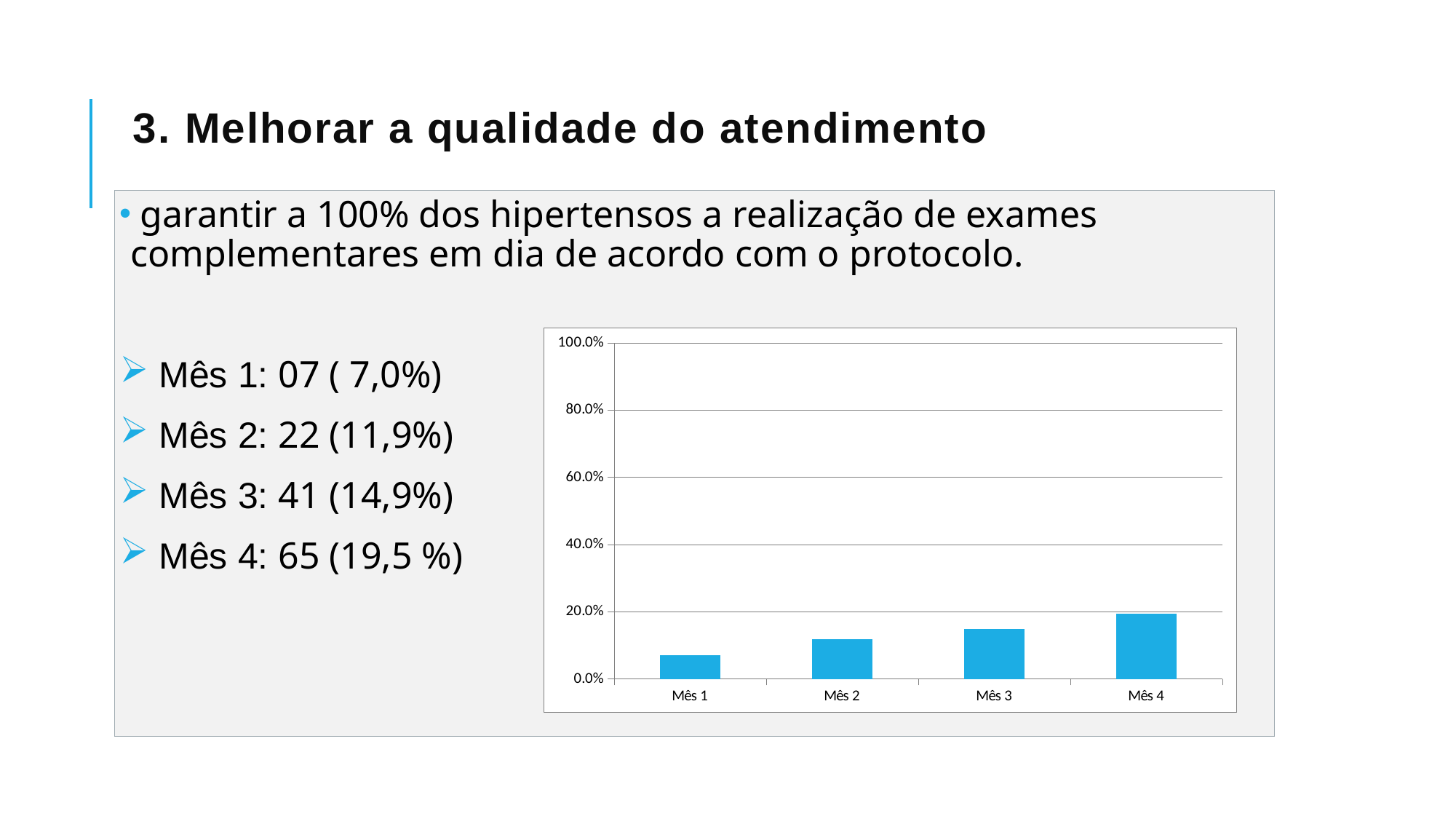
Which month has the highest bar in the chart? Mês 4 Which is larger, the value for Mês 1 or the value for Mês 4? Mês 4 Is the value for Mês 1 greater or less than 20.0%? less Do the bar values rise or fall from Mês 1 to Mês 4? rise How many categories are shown on the x axis of the chart? 4 Is the value for Mês 3 greater or less than 20.0%? less Is the bar for Mês 3 larger or smaller than the bar for Mês 2? larger What is the highest value shown on the chart's y axis? 100.0% What kind of chart is shown on the slide? bar chart What colour are the bars in the chart? blue Which month has the lowest bar in the chart? Mês 1 Is the value for Mês 4 greater or less than 40.0%? less